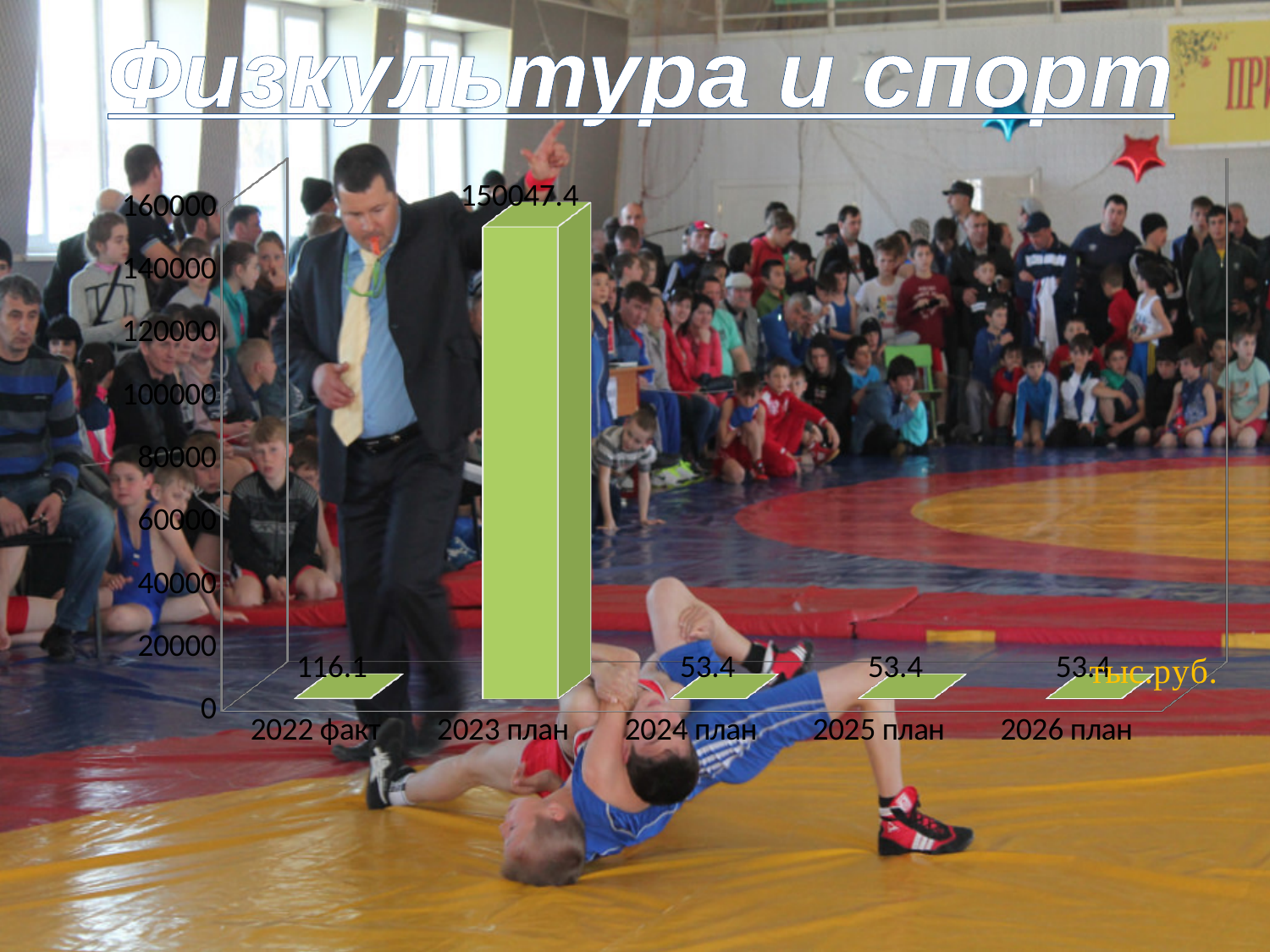
Is the value for 2023 план greater or less than 140000? greater What is the value for 2025 план? 53.4 How many categories are shown on the x axis? 5 What is the value for 2022 факт? 116.1 What is the value for 2023 план? 150047.4 What is the difference between the values for 2022 факт and 2024 план? 62.7 What is the difference between the values for 2023 план and 2022 факт? 149931.3 Which is larger, the value for 2022 факт or the value for 2026 план? 2022 факт What kind of chart is shown on the slide? bar chart What unit label is shown next to the chart? тыс.руб. Which category has the highest value? 2023 план What is the title of the slide? Физкультура и спорт